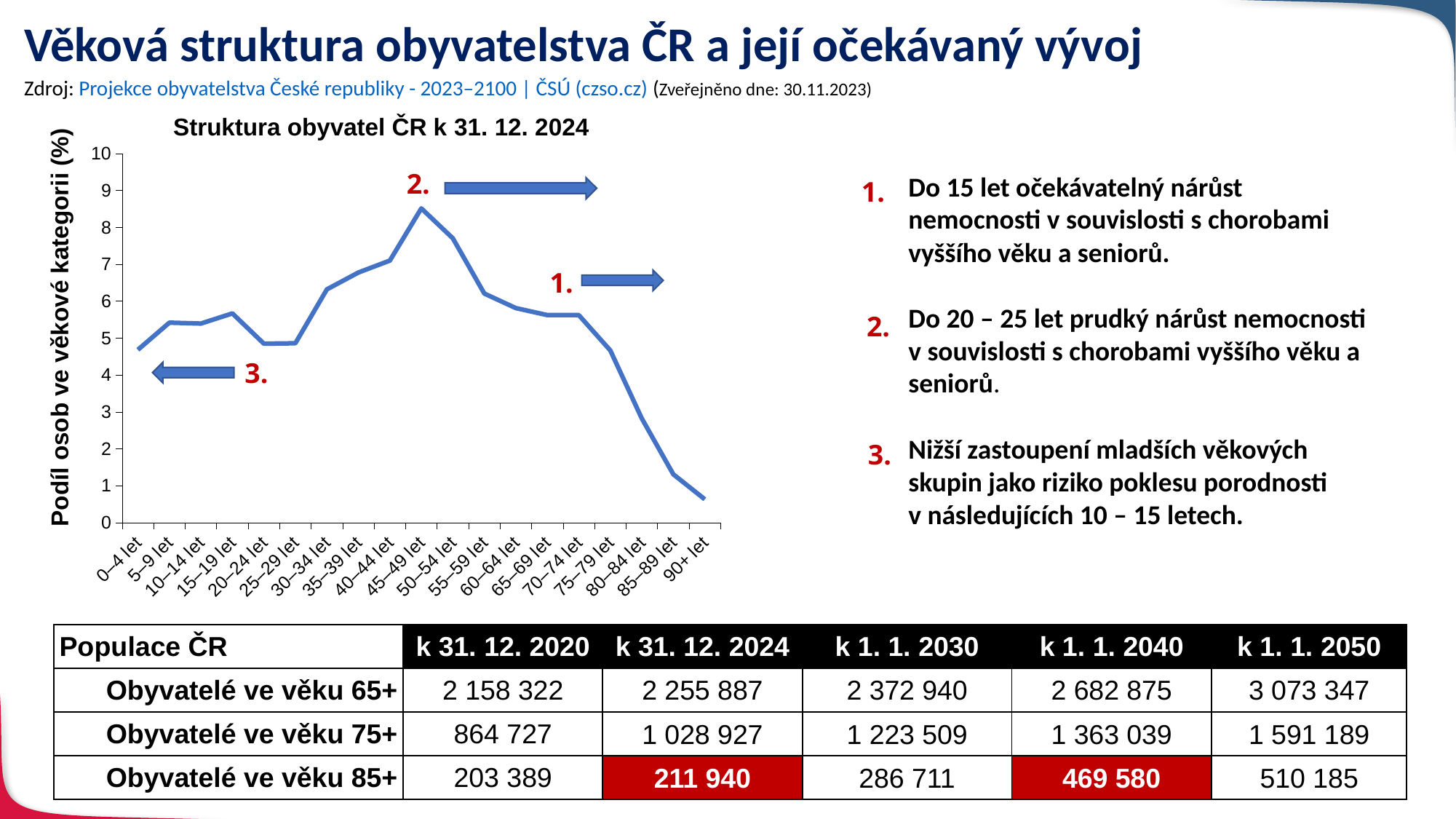
Is the value for 80–84 let greater or less than 4? less Which age category has the lowest value in the chart? 90+ let What kind of chart is shown on the slide? line chart Do the values rise or fall along the x axis from 45–49 let to 90+ let? fall What is the label of the vertical axis of the chart? Podíl osob ve věkové kategorii (%) Which has a larger value, 30–34 let or 80–84 let? 30–34 let How many age categories are plotted along the x axis of the chart? 19 Which age category has the highest value in the chart? 45–49 let Is the value for 0–4 let greater or less than 5? less What is the title of the chart? Struktura obyvatel ČR k 31. 12. 2024 Is the value for 45–49 let greater or less than 8? greater